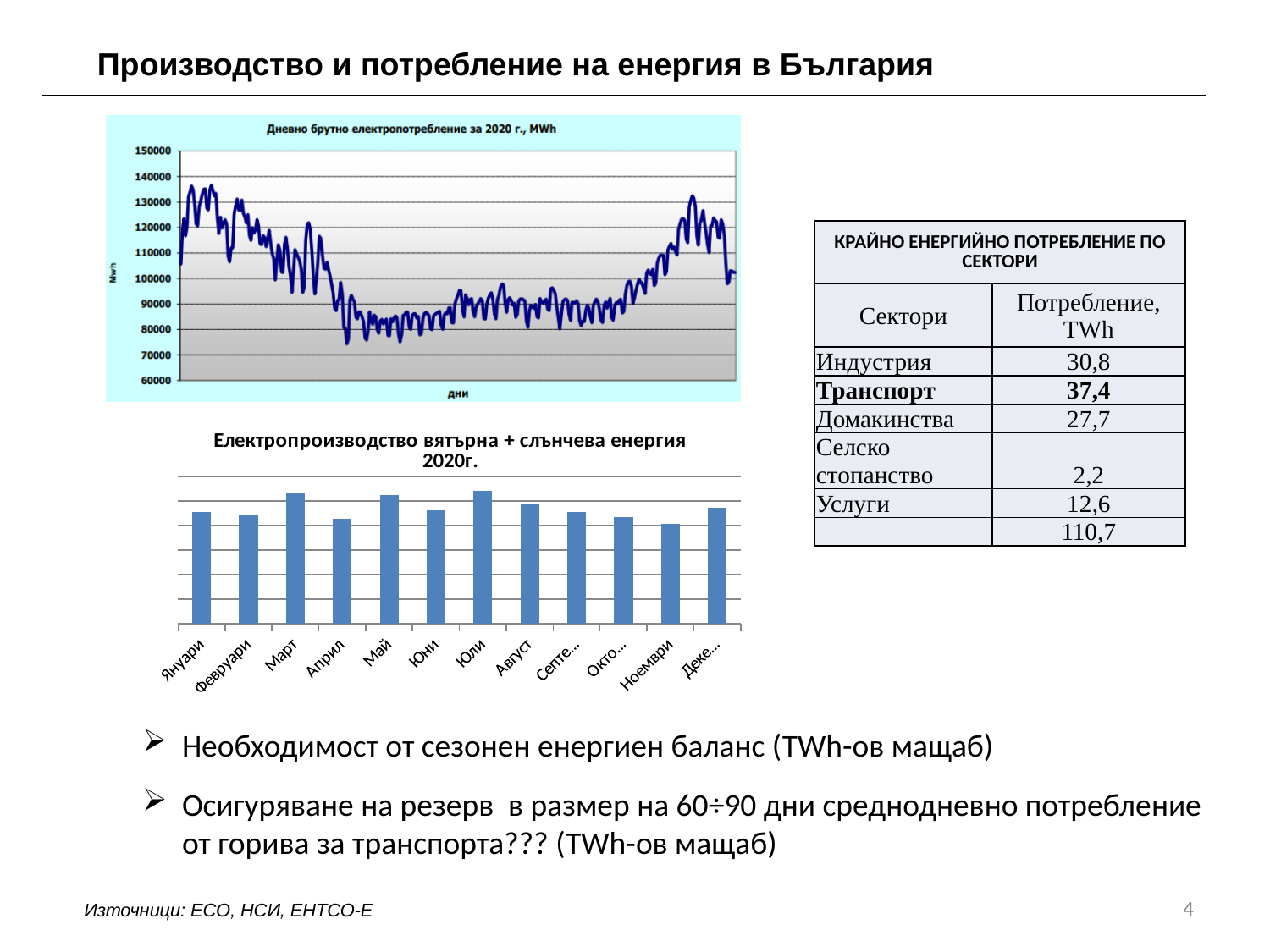
In the line chart 'Дневно брутно електропотребление за 2020 г., MWh', do the values generally rise or fall from the start of the year to the middle of the year? fall In the bar chart 'Електропроизводство вятърна + слънчева енергия 2020г.', how many months are shown? 12 What kind of chart is the top-left chart titled 'Дневно брутно електропотребление за 2020 г., MWh'? line chart What is the label on the vertical axis of the line chart 'Дневно брутно електропотребление за 2020 г., MWh'? Mwh What kind of chart is the chart titled 'Електропроизводство вятърна + слънчева енергия 2020г.'? bar chart In the bar chart 'Електропроизводство вятърна + слънчева енергия 2020г.', which is larger, the value for Ноември or the value for Декември? Декември What is the label on the horizontal axis of the line chart 'Дневно брутно електропотребление за 2020 г., MWh'? дни In the bar chart 'Електропроизводство вятърна + слънчева енергия 2020г.', which month has the lowest value? Ноември In the bar chart 'Електропроизводство вятърна + слънчева енергия 2020г.', which is larger, the value for Март or the value for Април? Март In the line chart 'Дневно брутно електропотребление за 2020 г., MWh', is the lowest value on the line greater or less than 80000? less In the line chart 'Дневно брутно електропотребление за 2020 г., MWh', is the highest value on the line greater or less than 140000? less